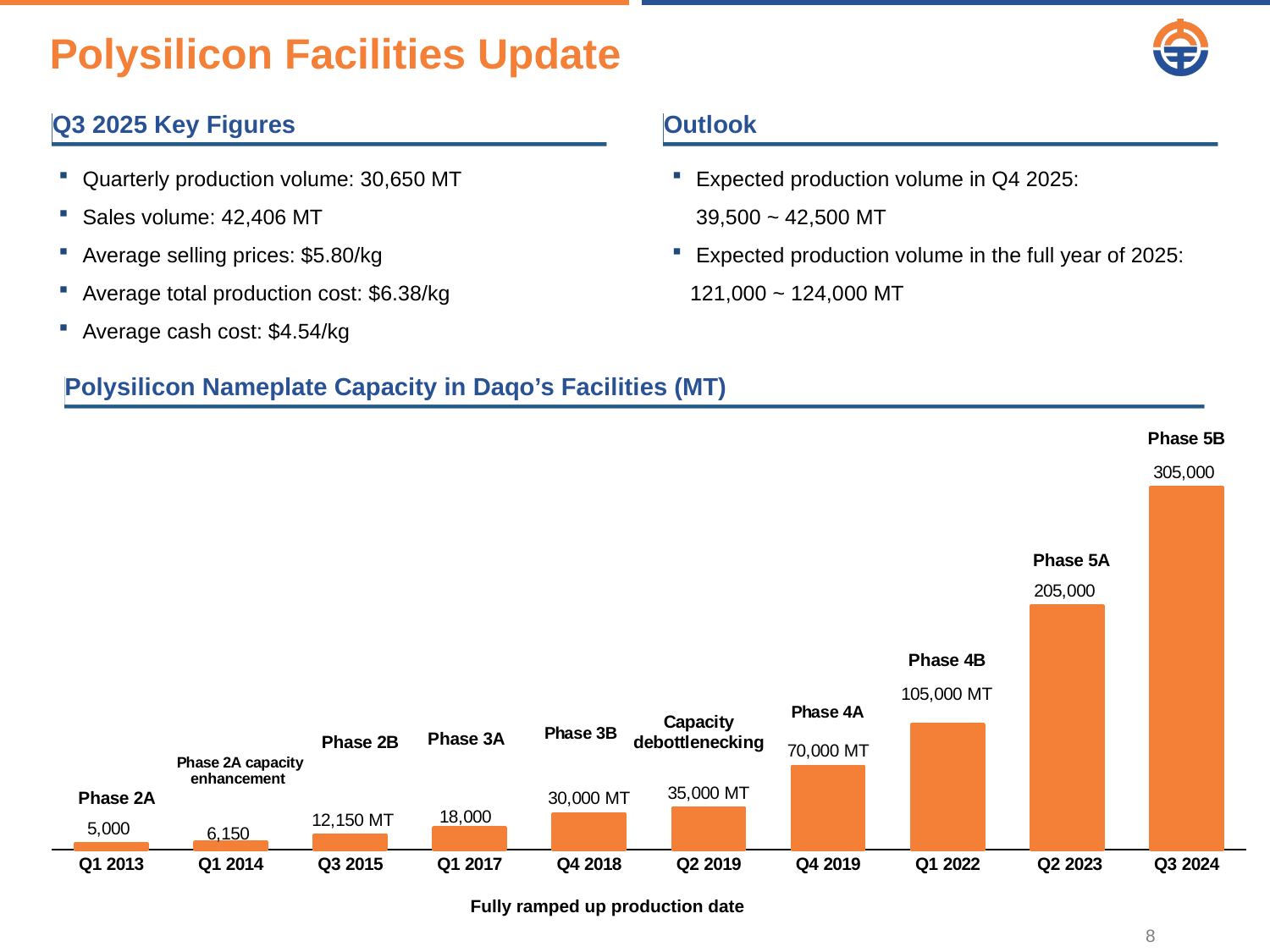
Which phase label is shown above the Q2 2023 bar? Phase 5A What is the nameplate capacity shown for Q3 2024? 305,000 Which fully ramped up production date has the highest nameplate capacity? Q3 2024 Which has a larger nameplate capacity, Q1 2017 or Q4 2018? Q4 2018 What is the nameplate capacity shown for Q1 2022? 105,000 MT What is the nameplate capacity shown for Q1 2013? 5,000 What is the difference in nameplate capacity between Q4 2019 and Q2 2019? 35,000 MT Do the nameplate capacity values rise or fall from Q1 2013 to Q3 2024? Rise What kind of chart is used to show the polysilicon nameplate capacity? Bar chart Which fully ramped up production date has the lowest nameplate capacity? Q1 2013 How many fully ramped up production dates are shown on the x axis of the chart? 10 What is the difference in nameplate capacity between Q3 2024 and Q2 2023? 100,000